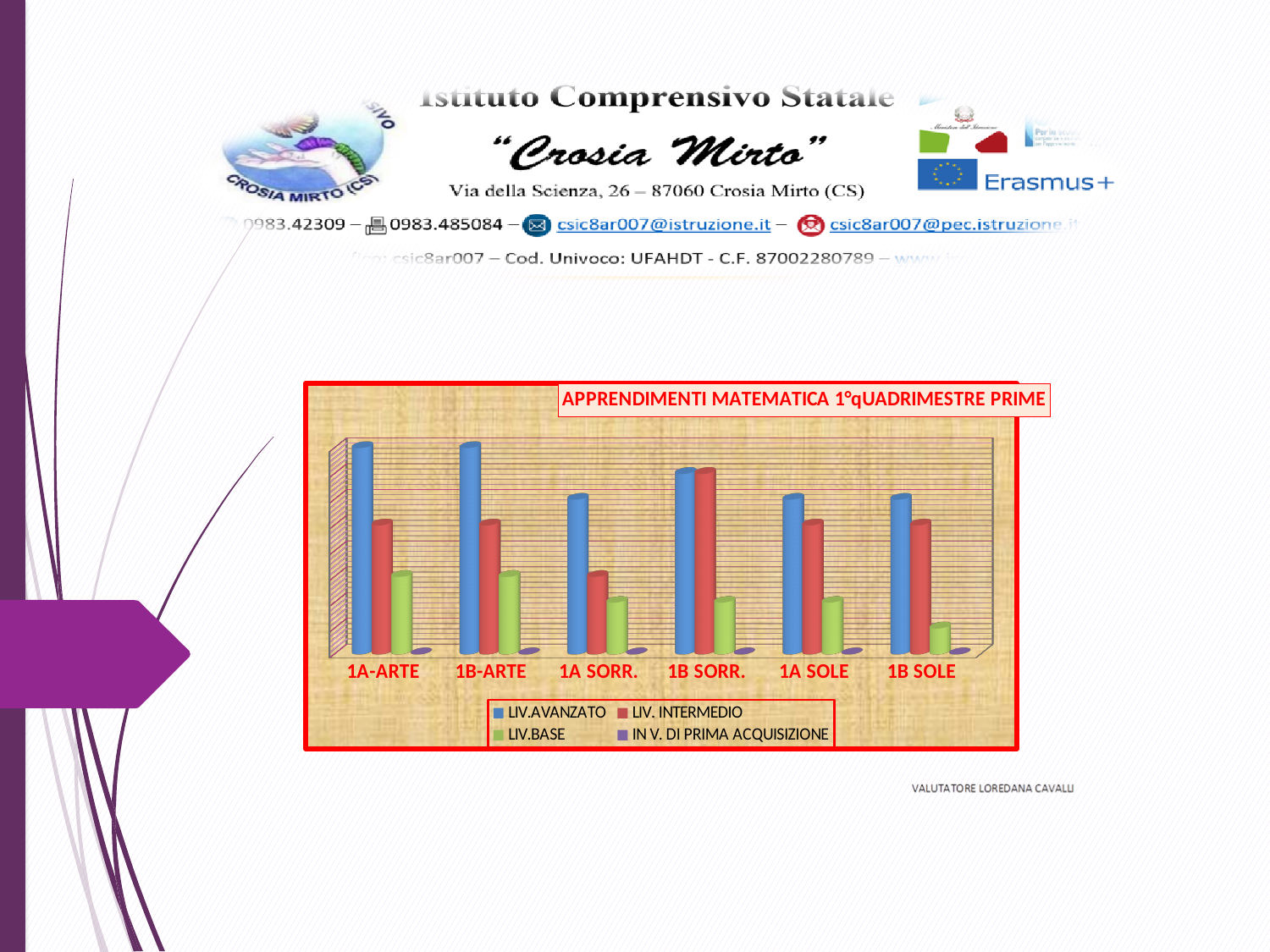
Which category has the lowest LIV. INTERMEDIO bar? 1A SORR. In the 1B SOLE category, which is larger: LIV. INTERMEDIO or LIV.BASE? LIV. INTERMEDIO How many series does the chart's legend list? 4 Which colour represents LIV.AVANZATO in the chart? Blue What is the title of the chart? APPRENDIMENTI MATEMATICA 1°qUADRIMESTRE PRIME In the 1A-ARTE category, which is larger: LIV.AVANZATO or LIV. INTERMEDIO? LIV.AVANZATO Which series has the lowest bar in every category of the chart? IN V. DI PRIMA ACQUISIZIONE How many categories (classes) are shown on the x axis of the chart? 6 What kind of chart is shown on the slide? Bar chart Which category has the highest LIV. INTERMEDIO bar? 1B SORR. Which category has the lowest LIV.BASE bar? 1B SOLE In the 1A SORR. category, which is larger: LIV.AVANZATO or LIV.BASE? LIV.AVANZATO